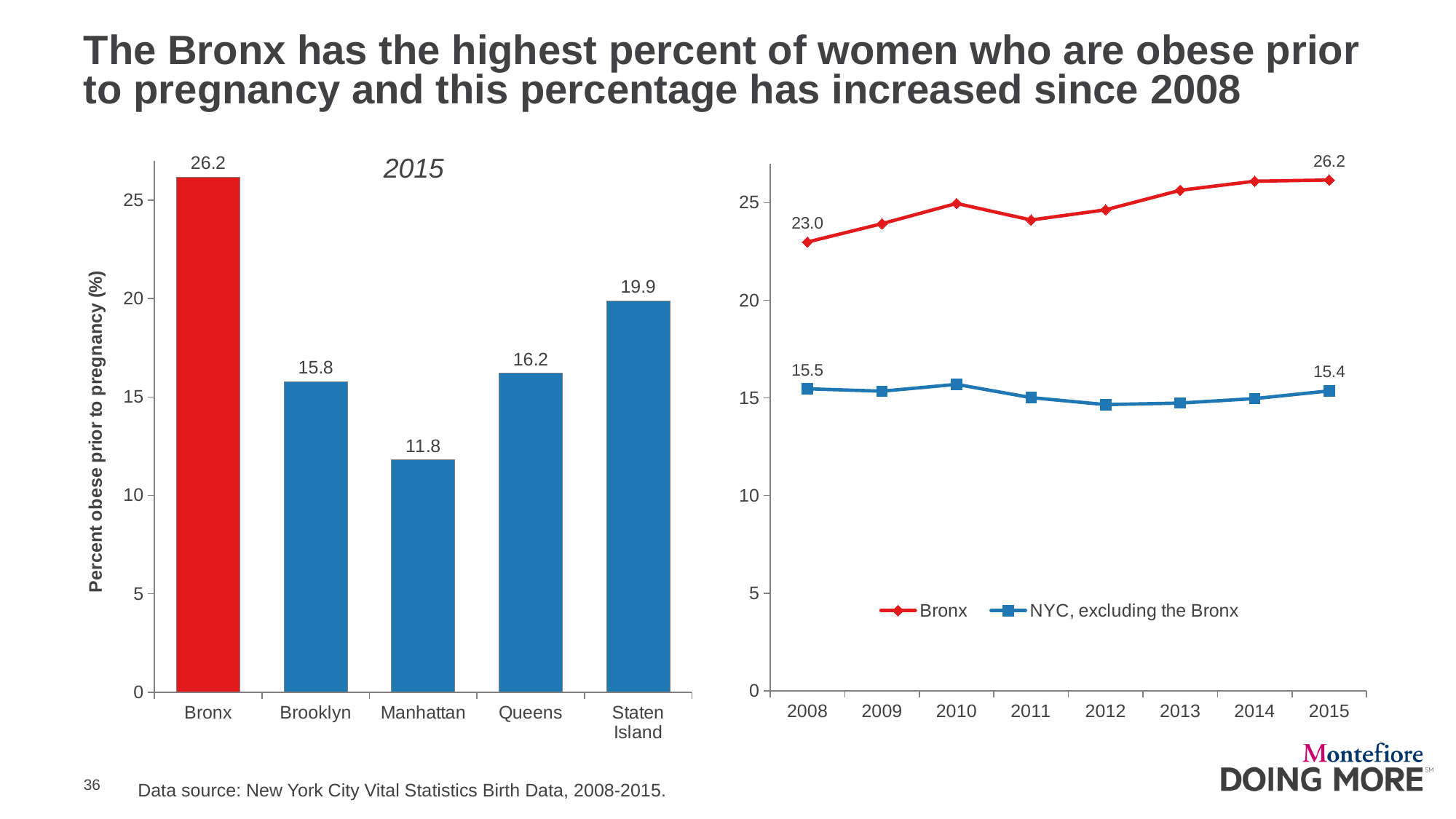
In the left bar chart titled 2015, which borough has the highest percent obese prior to pregnancy? Bronx In the right line chart, how many series does the legend list? 2 In the left bar chart titled 2015, which is larger, the value for Queens or the value for Brooklyn? Queens In the right line chart, does the Bronx series rise or fall from 2008 to 2015? rise In the left bar chart titled 2015, what is the difference between the values for Bronx and Staten Island? 6.3 In the left bar chart titled 2015, what is the value for Manhattan? 11.8 In the right line chart, what is the value for Bronx in 2008? 23.0 How many boroughs are shown in the left bar chart titled 2015? 5 In the left bar chart titled 2015, which borough has the lowest percent obese prior to pregnancy? Manhattan In the right line chart, is the value for Bronx in 2013 greater or less than 25? greater In the right line chart, what is the value for NYC, excluding the Bronx in 2015? 15.4 What kind of chart is the chart on the left of the slide? bar chart